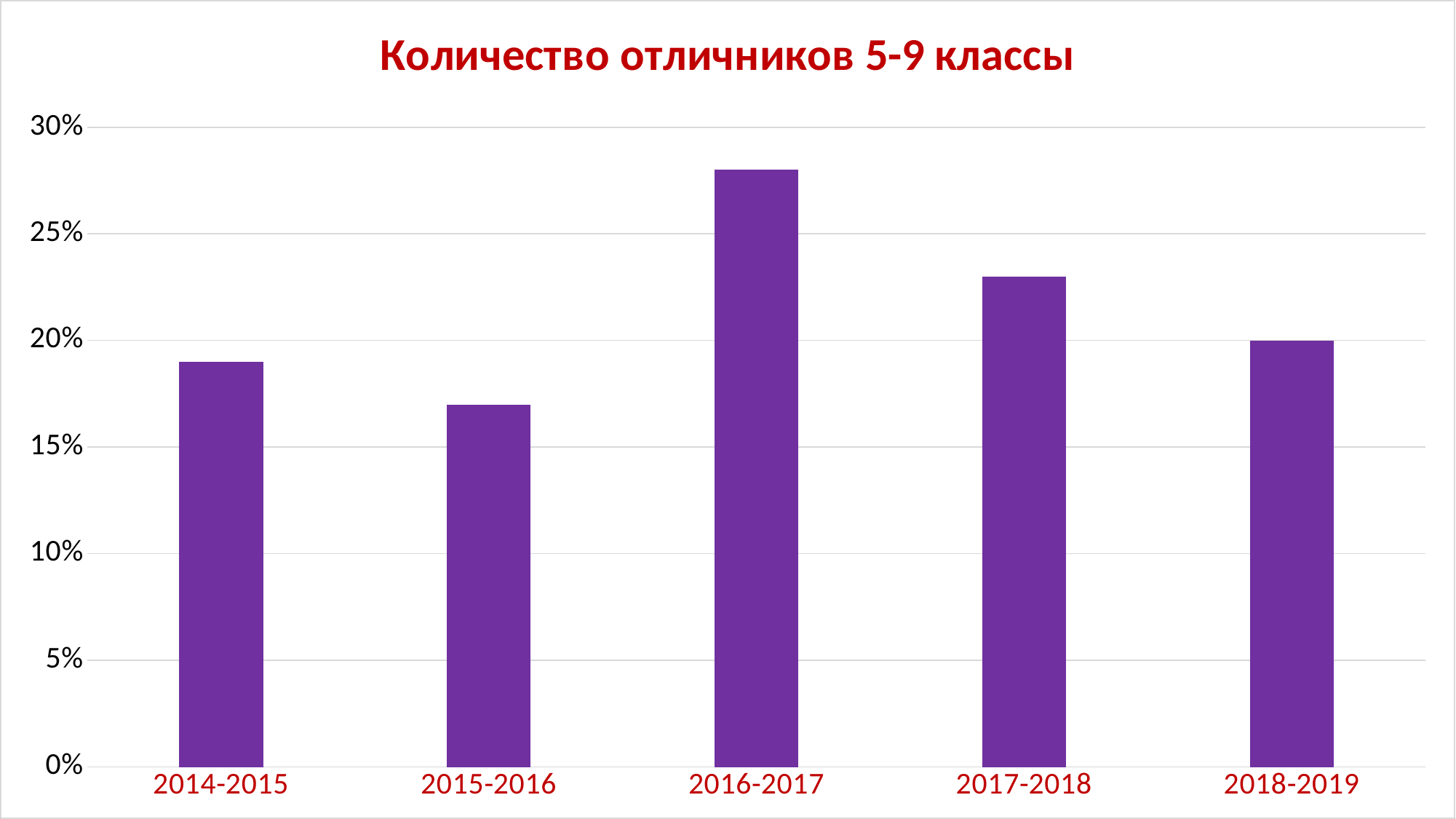
What kind of chart is shown on the slide? Bar chart How many school years are shown on the x axis? 5 Which is larger, the value for 2014-2015 or the value for 2015-2016? 2014-2015 Is the value for 2016-2017 greater or less than 25%? greater Which is larger, the value for 2016-2017 or the value for 2017-2018? 2016-2017 Is the value for 2014-2015 greater or less than 20%? less What is the title of the chart? Количество отличников 5-9 классы Does the value rise or fall from 2015-2016 to 2016-2017? rise Is the value for 2017-2018 greater or less than 25%? less Which school year has the highest value? 2016-2017 Which school year has the lowest value? 2015-2016